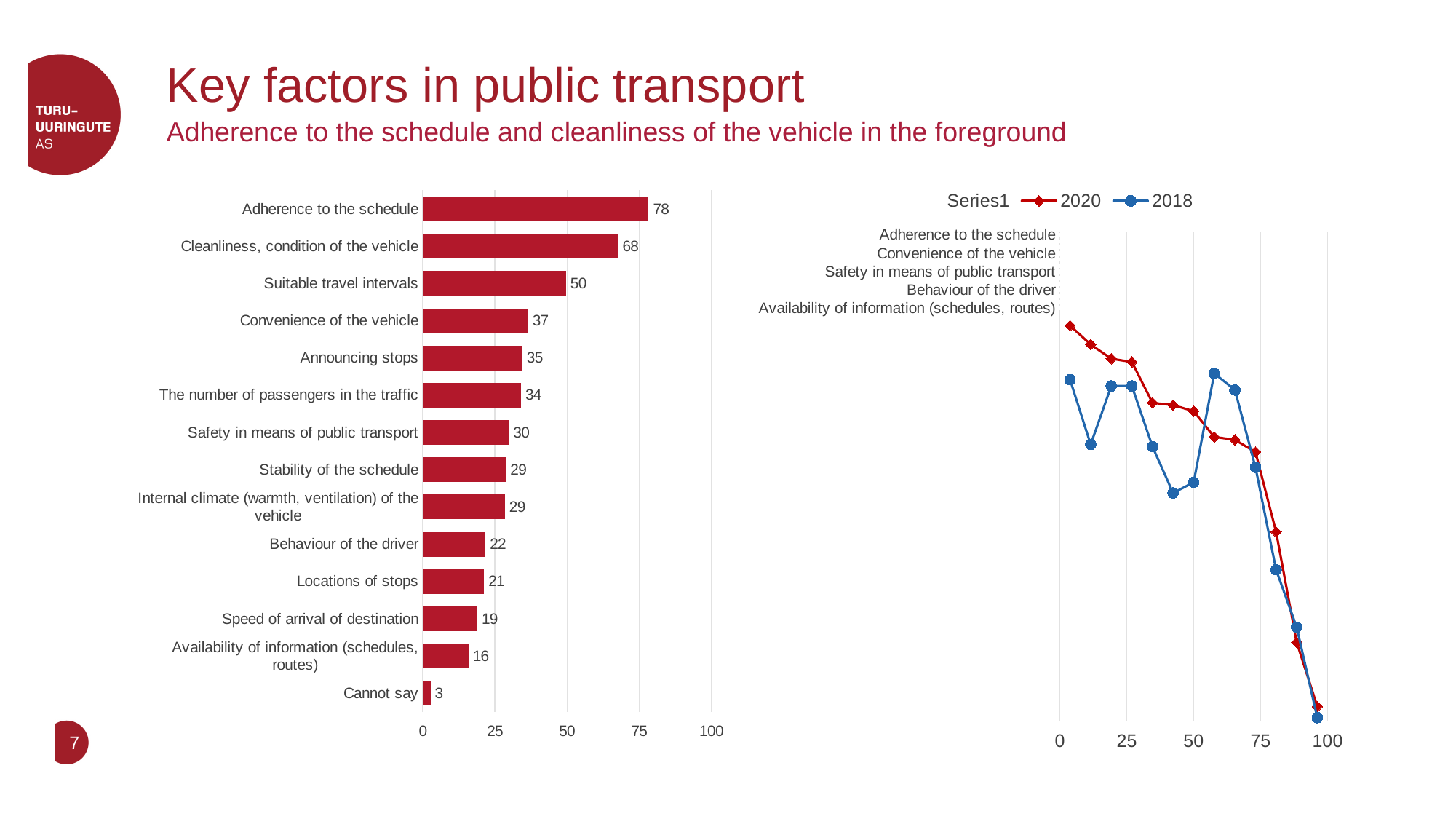
On the left bar chart, what is the value for Suitable travel intervals? 50 On the left bar chart, is the value for Convenience of the vehicle greater or less than 25? greater How many series does the legend of the right chart list? 3 On the left bar chart, which category has the lowest value? Cannot say On the left bar chart, which is larger: Announcing stops or Safety in means of public transport? Announcing stops On the left bar chart, what is the difference between Adherence to the schedule and Cleanliness, condition of the vehicle? 10 What kind of chart is the chart on the left of the slide? bar chart On the left bar chart, what is the value for Behaviour of the driver? 22 How many categories does the left bar chart show? 14 On the left bar chart, which category has the highest value? Adherence to the schedule On the left bar chart, what is the value for Availability of information (schedules, routes)? 16 On the left bar chart, what is the value for Adherence to the schedule? 78